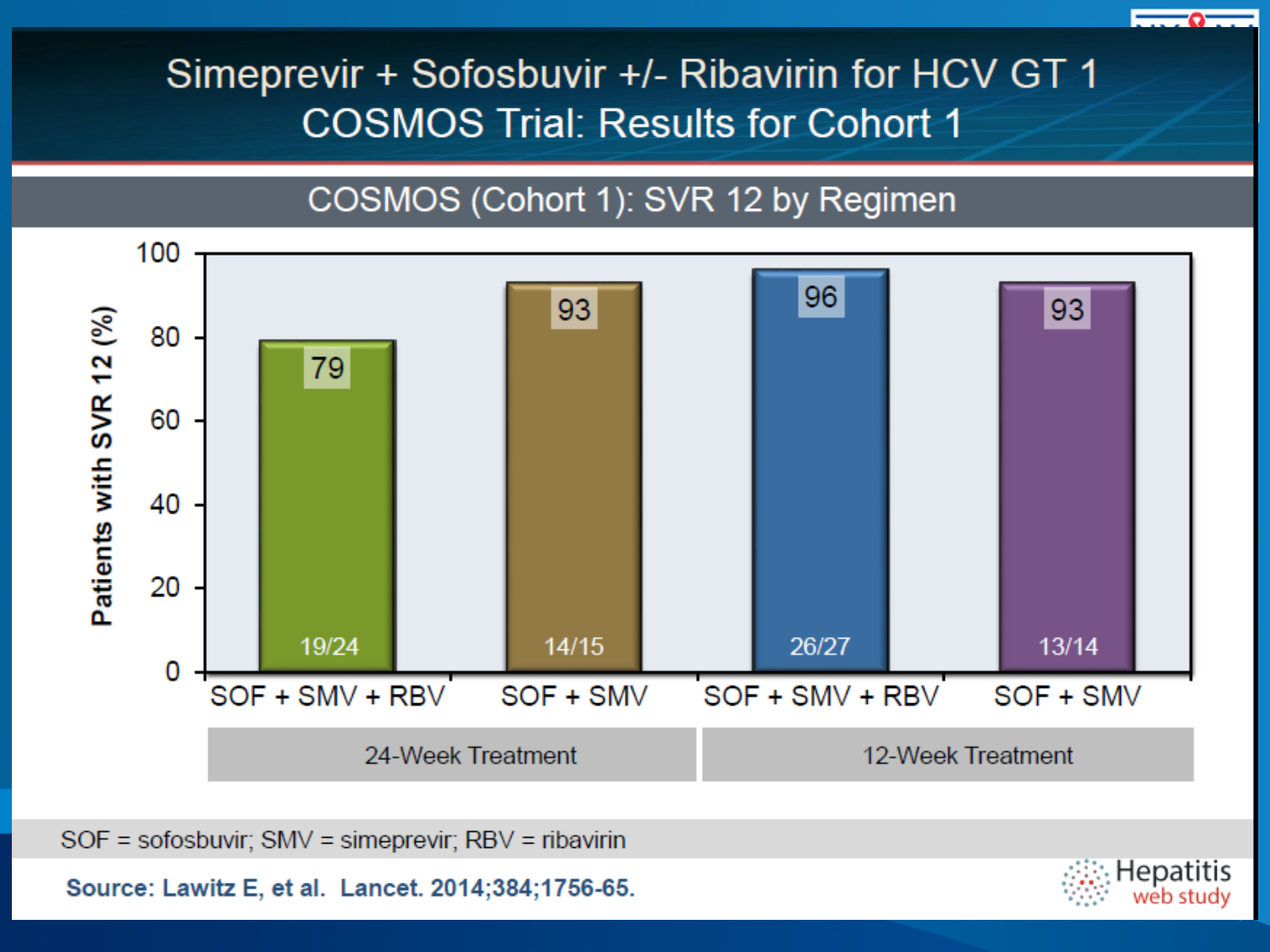
Which regimen has the highest SVR 12 rate? SOF + SMV + RBV (12-Week Treatment) What is the SVR 12 rate for SOF + SMV + RBV in the 12-Week Treatment group? 96 What type of chart is used to show SVR 12 by regimen? bar chart What is the SVR 12 rate for SOF + SMV + RBV in the 24-Week Treatment group? 79 How many regimen bars are shown in the chart? 4 Is the SVR 12 rate for the 24-Week SOF + SMV + RBV arm greater or less than 80? less Which has a higher SVR 12 rate: 24-Week SOF + SMV + RBV or 24-Week SOF + SMV? SOF + SMV What is the SVR 12 rate for SOF + SMV in the 24-Week Treatment group? 93 What is the difference in SVR 12 rate between the 12-Week SOF + SMV + RBV arm and the 24-Week SOF + SMV + RBV arm? 17 Which regimen has the lowest SVR 12 rate? SOF + SMV + RBV (24-Week Treatment) How many patients achieved SVR 12 out of the total in the 12-Week SOF + SMV + RBV arm, as shown on the bar? 26/27 What is the label of the y-axis? Patients with SVR 12 (%)